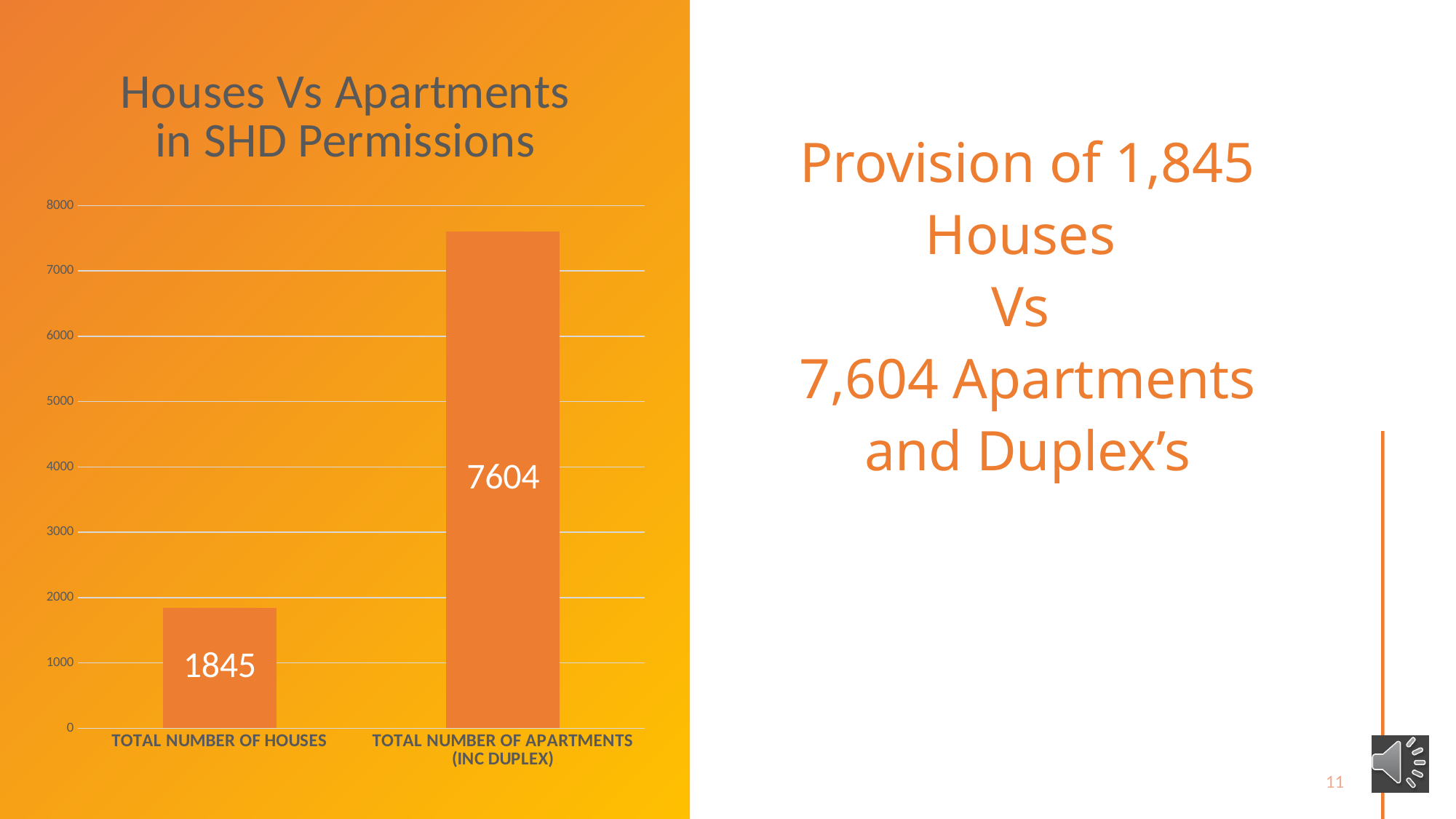
How many categories are shown on the chart? 2 Which category has the highest value? Total Number of Apartments (inc Duplex) Is the value for Total Number of Houses greater or less than 2000? less What is the highest value shown on the vertical axis of the chart? 8000 What is the difference between the value for Total Number of Apartments (inc Duplex) and the value for Total Number of Houses? 5759 What is the value for Total Number of Houses? 1845 What kind of chart is shown on the slide? Bar chart Which is larger, the value for Total Number of Houses or the value for Total Number of Apartments (inc Duplex)? Total Number of Apartments (inc Duplex) Which category has the lowest value? Total Number of Houses What is the value for Total Number of Apartments (inc Duplex)? 7604 Is the value for Total Number of Apartments (inc Duplex) greater or less than 7000? greater What is the title of the chart? Houses Vs Apartments in SHD Permissions